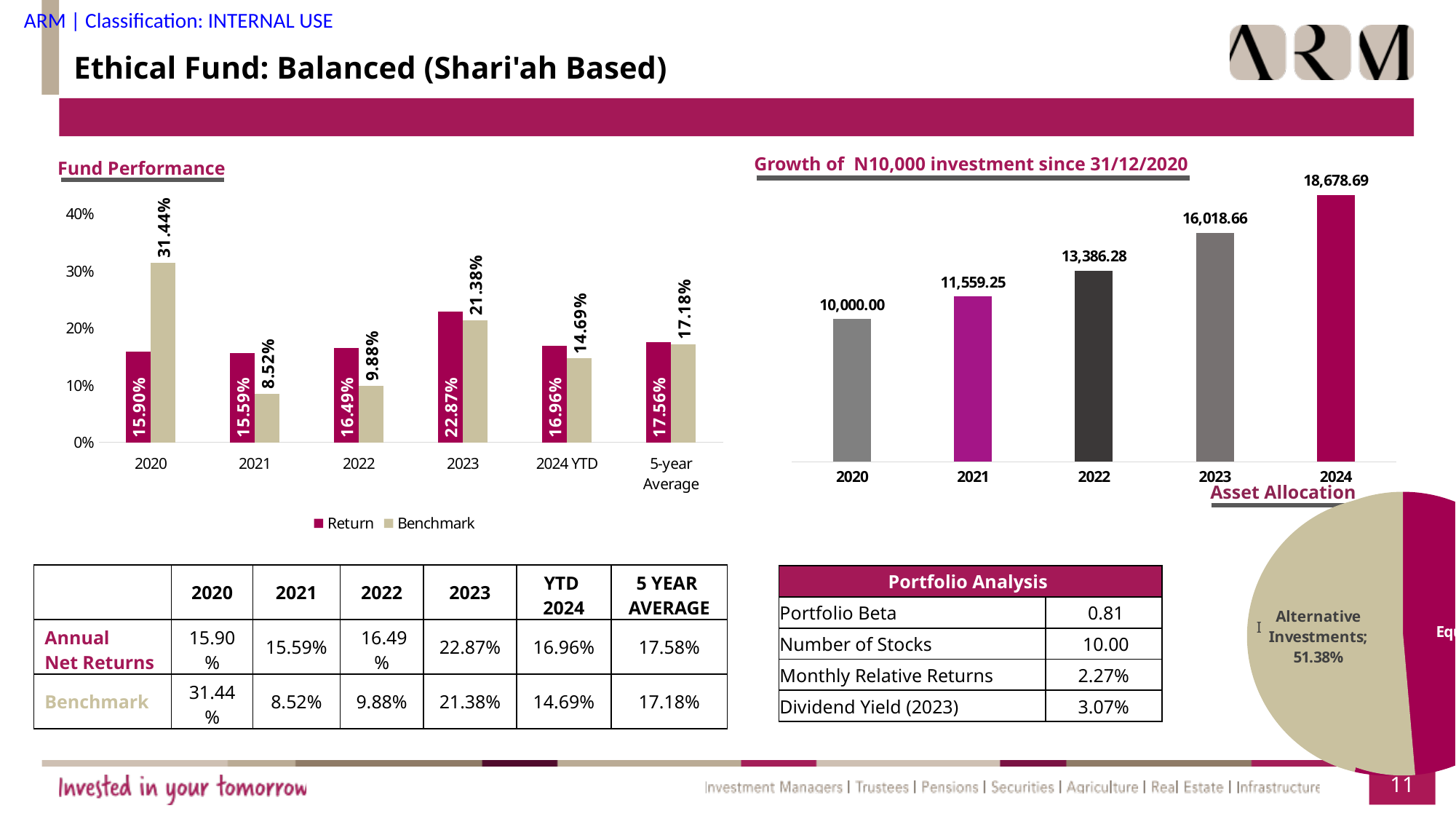
In the Fund Performance chart, which is larger for 2024 YTD, the Return or the Benchmark? Return In the Fund Performance chart, what is the Return value for 2023? 22.87% In the Growth of N10,000 investment chart, what is the value for 2022? 13,386.28 In the Fund Performance chart, which year has the highest Benchmark value? 2020 In the Fund Performance chart, which category has the lowest Benchmark value? 2021 How many bars are in the Growth of N10,000 investment chart? 5 In the Asset Allocation pie chart, what share is Alternative Investments? 51.38% In the Fund Performance chart, what is the difference between the Return and Benchmark values for 2021? 7.07% How many series does the legend of the Fund Performance chart list? 2 In the Growth of N10,000 investment chart, do the values rise or fall from 2020 to 2024? Rise What kind of chart is the Growth of N10,000 investment since 31/12/2020 chart? Bar chart In the Fund Performance chart, what is the Benchmark value for 2020? 31.44%